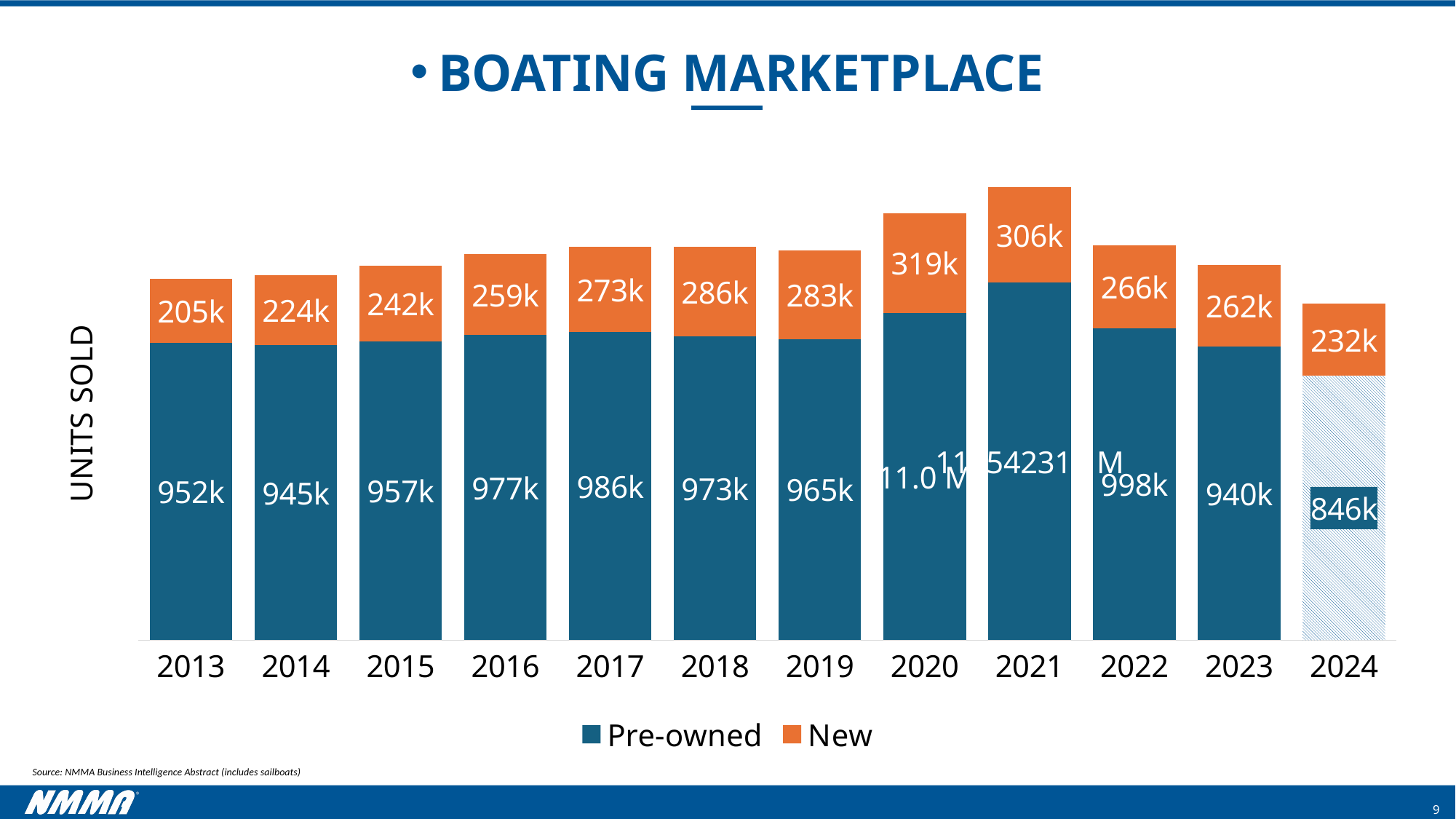
How many series does the legend list? 2 Which year has the lowest value for Pre-owned boats? 2024 Do the New boat values rise or fall from 2013 to 2018? Rise What is the value for New boats in 2020? 319k Which year has the highest value for New boats? 2020 What is the value for New boats in 2024? 232k Which is larger, the Pre-owned value for 2022 or for 2023? 2022 What is the value for Pre-owned boats in 2017? 986k Which year has the lowest value for New boats? 2013 What kind of chart is shown on the slide? Stacked bar chart What is the difference between the New boat values for 2020 and 2013? 114k How many years are shown on the x axis? 12